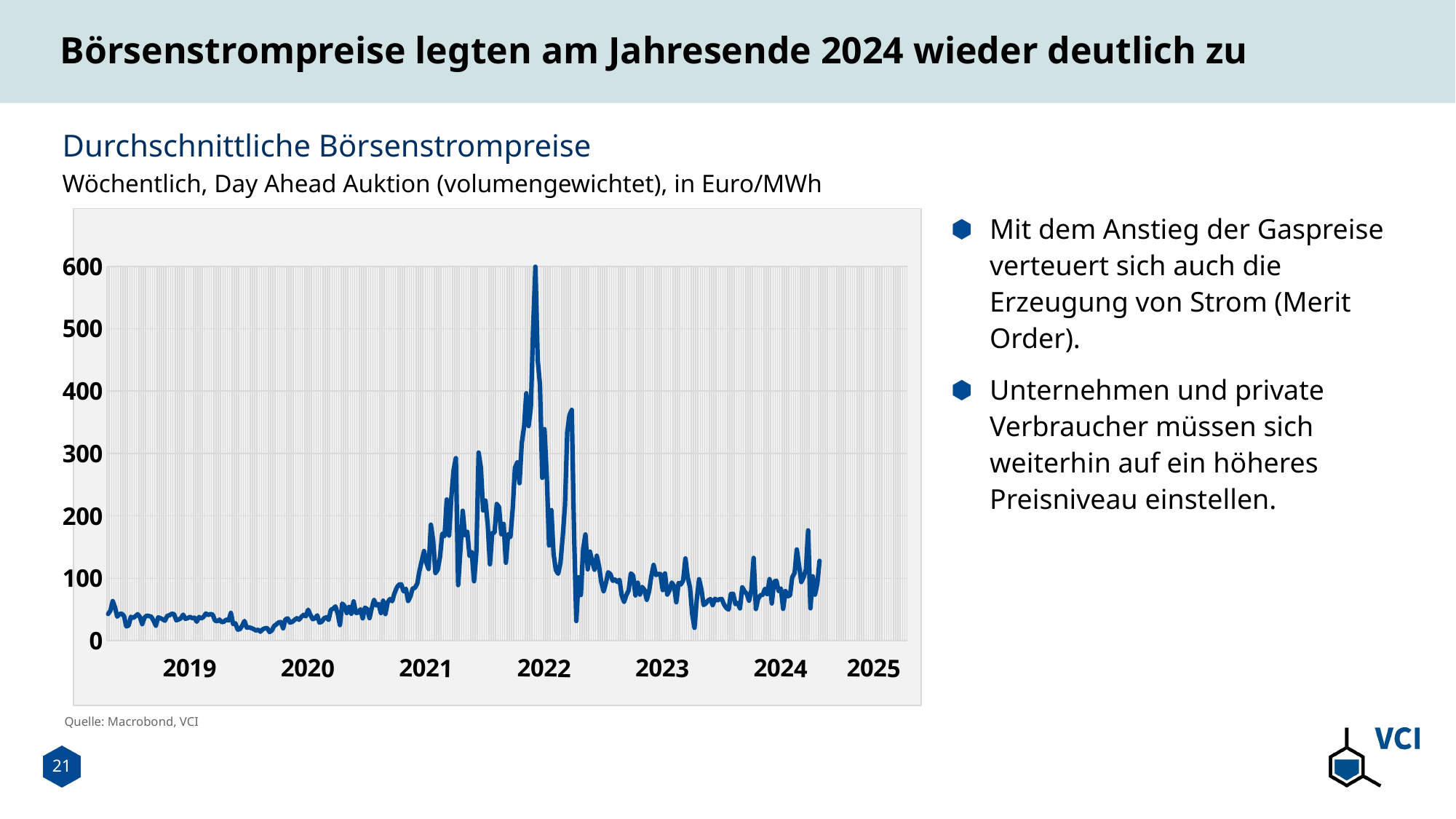
Are the values during 2023 greater or less than 200? less Is the value at the end of 2024 greater or less than the peak around the start of 2022? less Are the values at the start of 2020 greater or less than 100? less What kind of chart is shown on the slide? line chart What is the highest tick value shown on the y axis? 600 Is the highest value reached by the line greater or less than 500? greater What is the title of the chart? Durchschnittliche Börsenstrompreise In what unit are the values on the chart given? Euro/MWh How many year labels are shown on the x axis? 7 Do the values rise or fall from the peak around the start of 2022 to the end of 2023? fall Do the values rise or fall from the start of 2021 to the end of 2021? rise